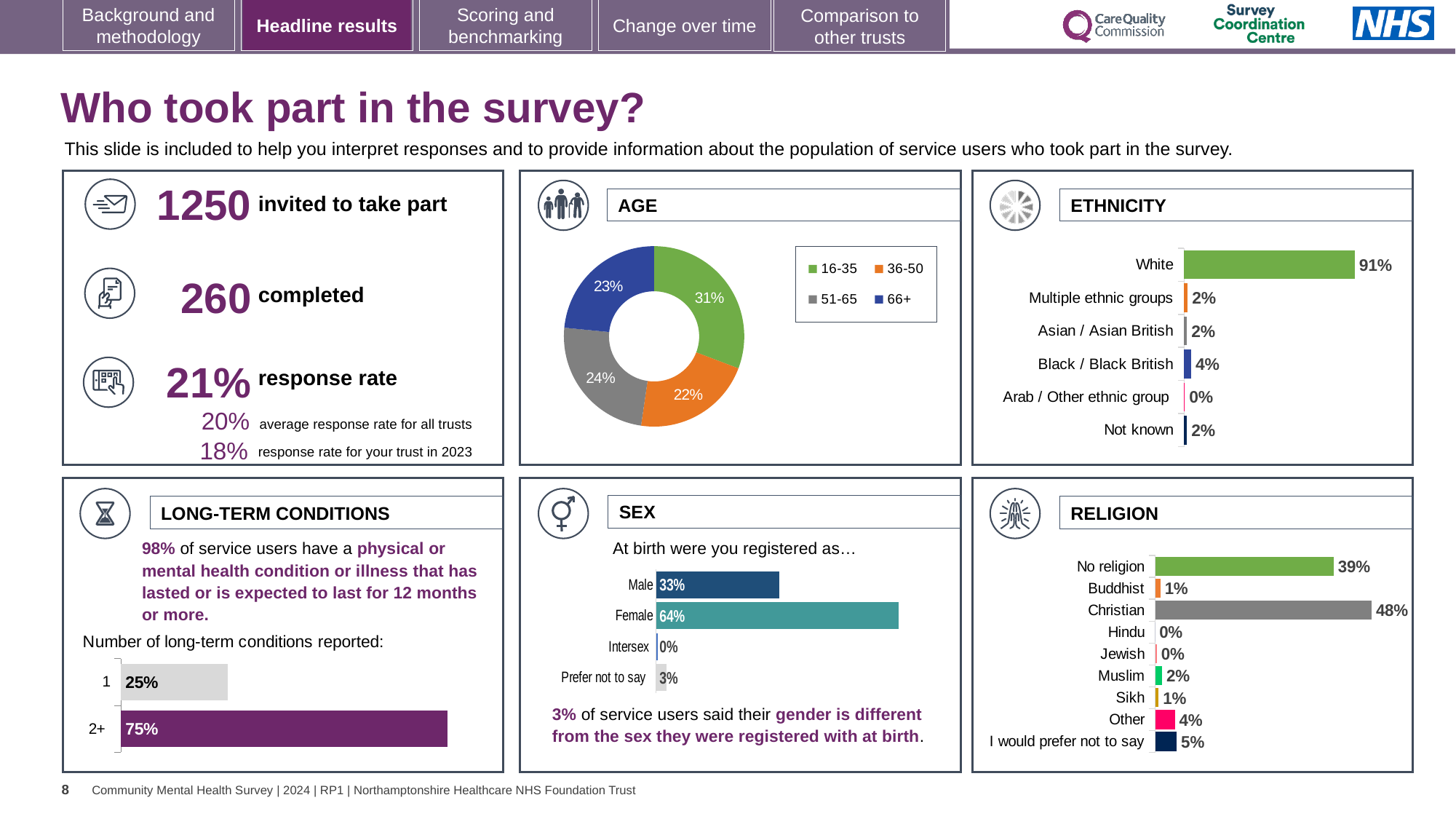
In the AGE chart, which age group has the smallest share? 36-50 How many entries does the legend of the AGE chart list? 4 In the ETHNICITY chart, which category has the highest value? White In the ETHNICITY chart, what is the value for Black / Black British? 4% In the LONG-TERM CONDITIONS chart, what percentage reported 2+ conditions? 75% In the SEX chart, what is the difference between the Female and Male values? 31% What kind of chart is the AGE chart? Doughnut chart In the SEX chart, which is larger, Male or Female? Female How many categories are shown in the ETHNICITY chart? 6 In the AGE chart, what percentage of respondents were aged 16-35? 31% In the RELIGION chart, what is the value for I would prefer not to say? 5% In the RELIGION chart, which category has the highest value? Christian